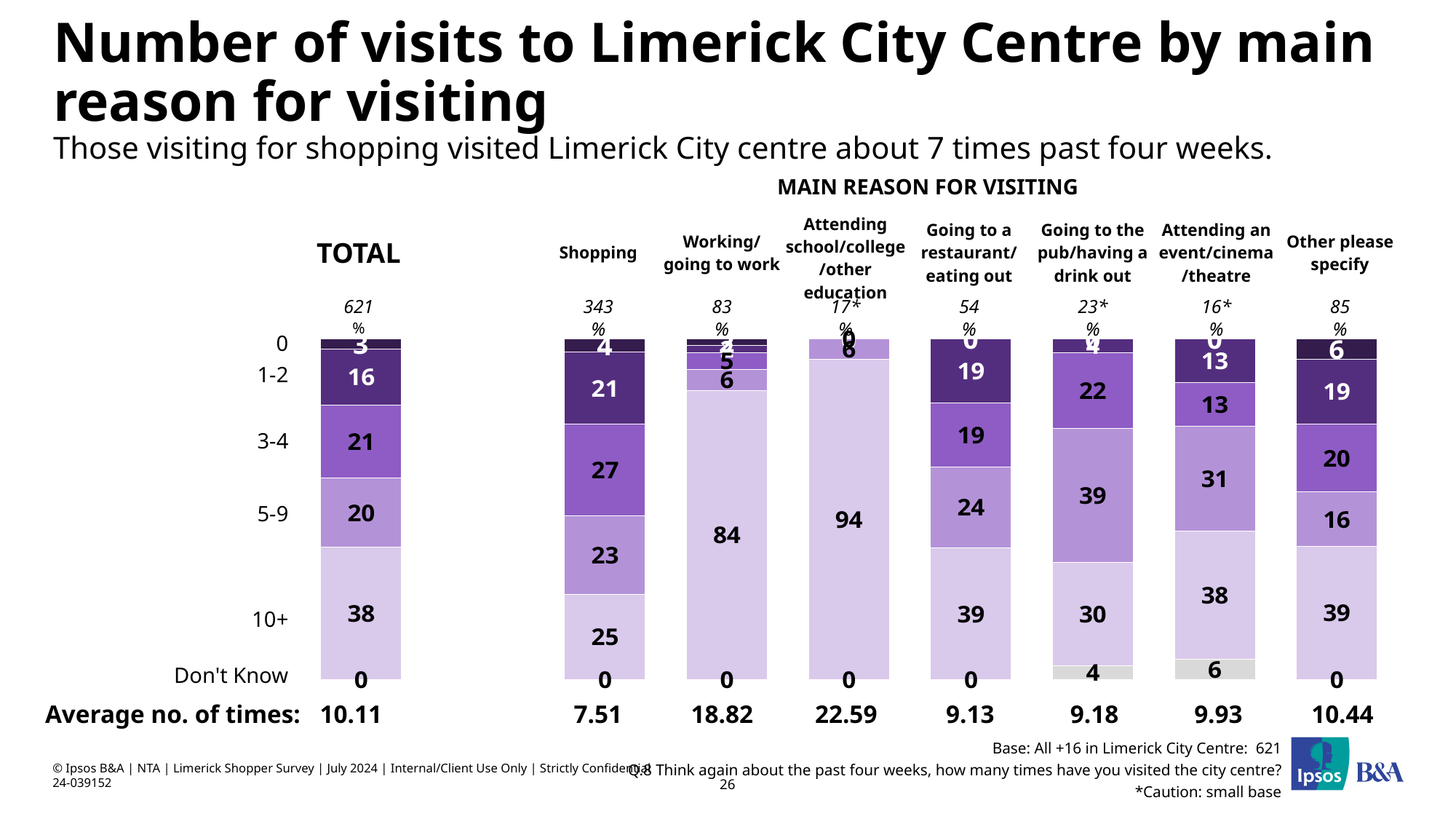
What is the Don't Know percentage for Attending an event/cinema/theatre? 6 What percentage of the TOTAL group visited 10+ times? 38 What percentage of those visiting for Shopping visited 3-4 times? 27 Which main reason for visiting has the highest share of 10+ visits? Attending school/college/other education What is the difference between the 10+ share for Going to a restaurant/eating out and for Going to the pub/having a drink out? 9 Which is larger: the 5-9 share for Going to the pub/having a drink out or for Attending an event/cinema/theatre? Going to the pub/having a drink out What is the average number of times for those visiting for Shopping? 7.51 What percentage of those Working/going to work visited 10+ times? 84 Which main reason for visiting has the highest average number of times? Attending school/college/other education What kind of chart is shown on the slide? Stacked bar chart How many bars (reason categories including TOTAL) are plotted in the chart? 8 What is the base size shown for the Shopping group? 343